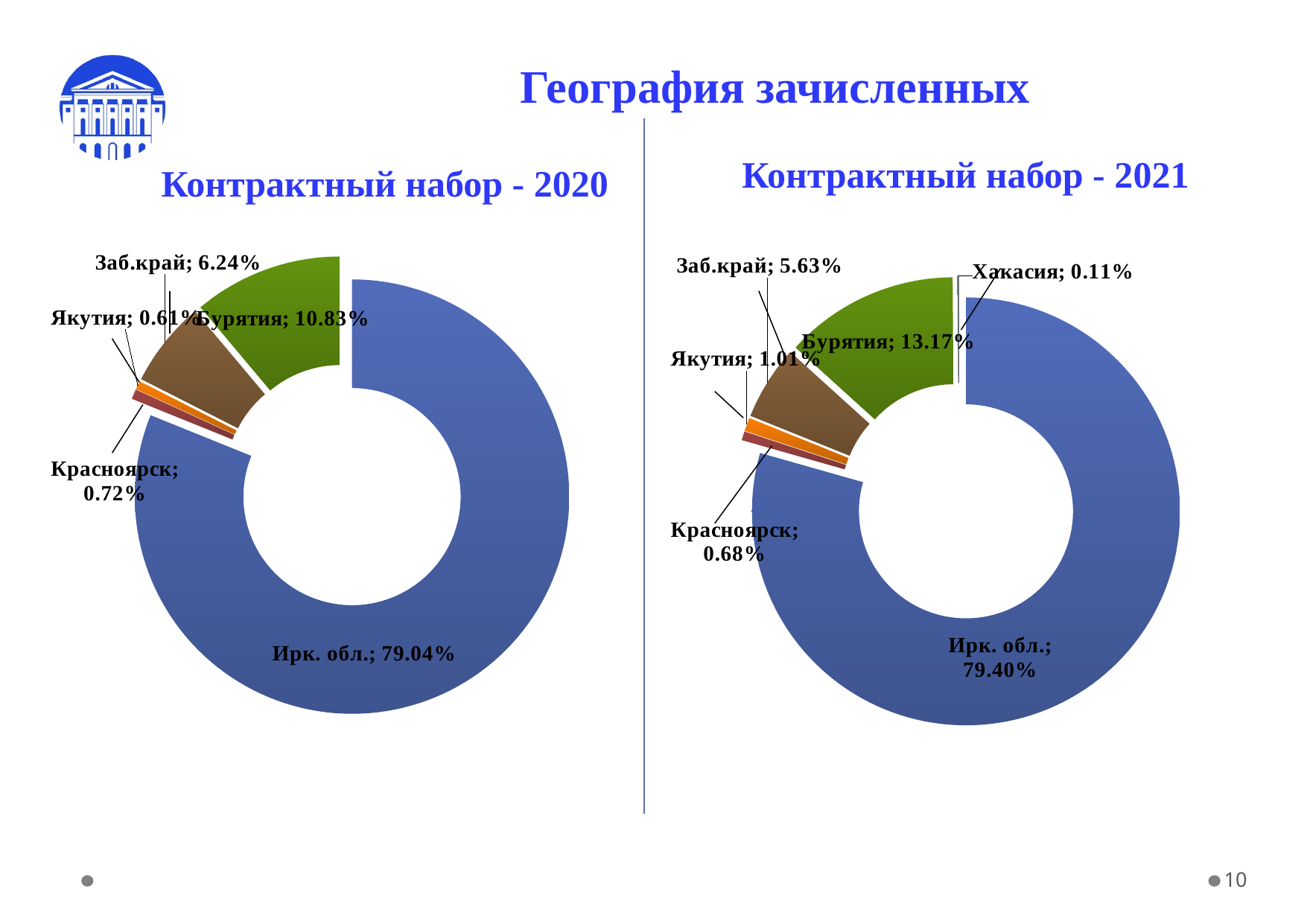
In the 'Контрактный набор - 2021' chart, what is the value for Хакасия? 0.11% In the 'Контрактный набор - 2021' chart, which region has the smallest share? Хакасия In the 'Контрактный набор - 2020' chart, which is larger: the share of Бурятия or the share of Заб.край? Бурятия What type of chart is used for 'Контрактный набор - 2020'? Pie (doughnut) chart In the 'Контрактный набор - 2020' chart, which region has the smallest share? Якутия How many regions are shown in the 'Контрактный набор - 2021' chart? 6 What is the main title of the slide? География зачисленных In the 'Контрактный набор - 2020' chart, which region has the largest share? Ирк. обл. In the 'Контрактный набор - 2021' chart, what is the difference between the shares of Бурятия and Заб.край? 7.54% In the 'Контрактный набор - 2020' chart, what share does Ирк. обл. have? 79.04% How many regions are shown in the 'Контрактный набор - 2020' chart? 5 In the 'Контрактный набор - 2021' chart, what share does Бурятия have? 13.17%